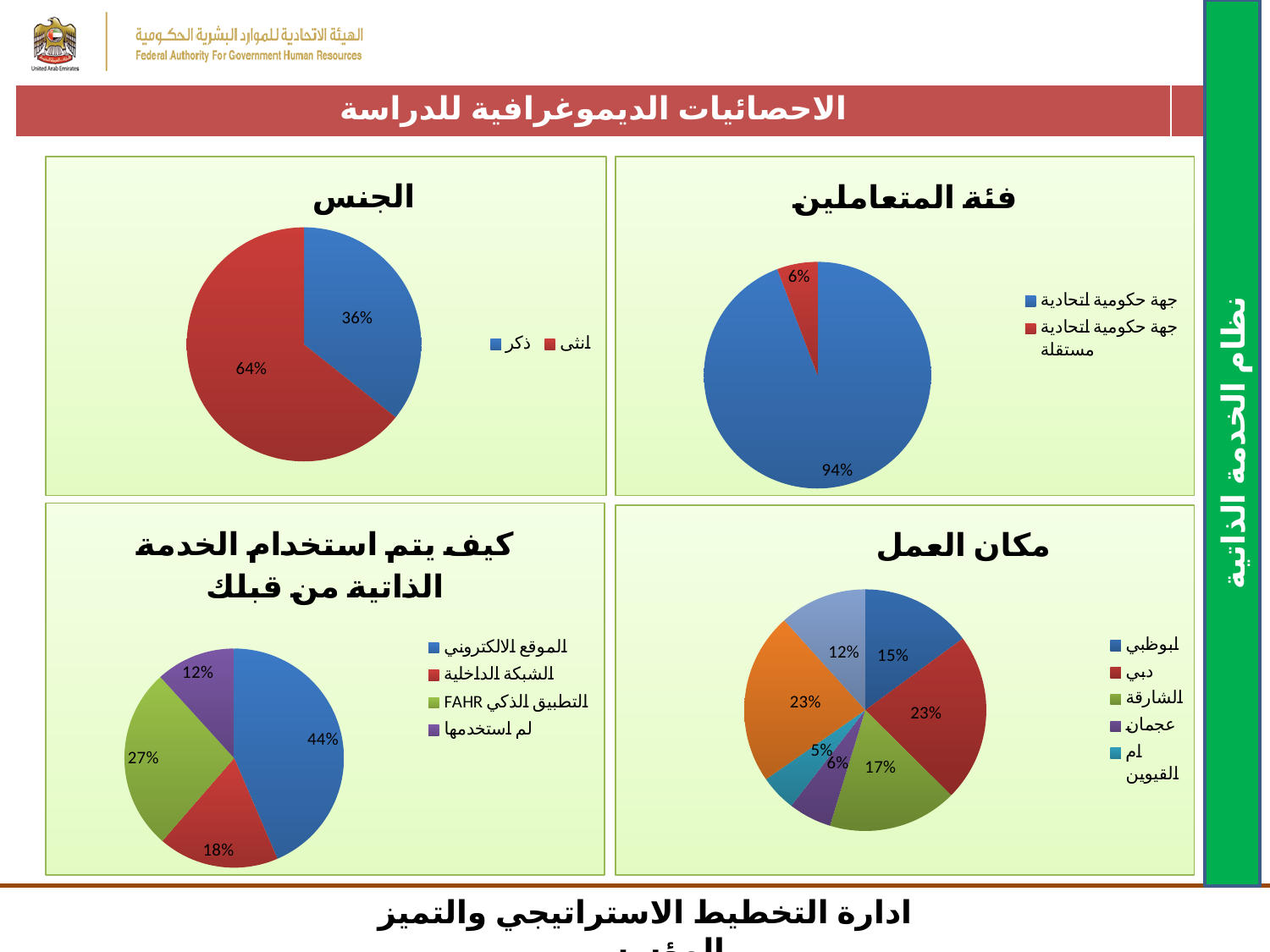
In the chart titled الجنس, what percentage is shown for ذكر? 36% In the chart titled مكان العمل, what is the difference in percentage points between الشارقة and ابوظبي? 2 In the chart titled كيف يتم استخدام الخدمة الذاتية من قبلك, which category has the highest share? الموقع الالكتروني In the chart titled مكان العمل, what percentage is shown for دبي? 23% In the chart titled الجنس, what percentage is shown for أنثى? 64% In the chart titled كيف يتم استخدام الخدمة الذاتية من قبلك, which category has the lowest share? لم استخدمها In the chart titled فئة المتعاملين, what is the difference in percentage points between جهة حكومية اتحادية and جهة حكومية اتحادية مستقلة? 88 In the chart titled الجنس, which category has the larger share, ذكر or أنثى? أنثى What type of chart is the chart titled مكان العمل? Pie chart In the chart titled فئة المتعاملين, what percentage is shown for جهة حكومية اتحادية? 94% In the chart titled فئة المتعاملين, how many series does the legend list? 2 In the chart titled كيف يتم استخدام الخدمة الذاتية من قبلك, what percentage is shown for التطبيق الذكي FAHR? 27%